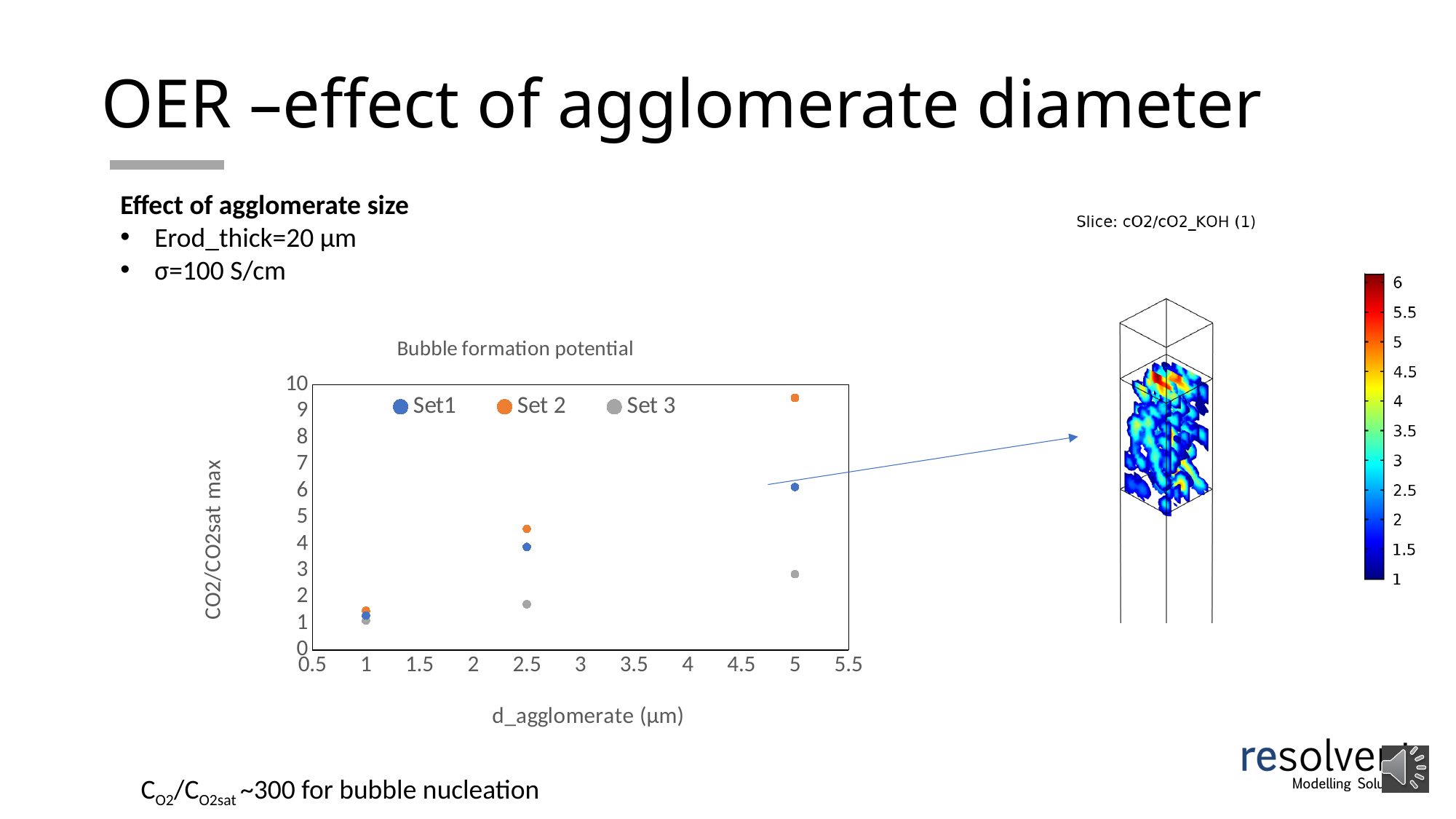
In the 'Bubble formation potential' chart, which is larger at d_agglomerate = 2.5 µm: Set1 or Set 2? Set 2 In the 'Bubble formation potential' chart, is the value for Set 3 at d_agglomerate = 5 µm greater or less than 4? less How many data points are plotted for Set 2 in the 'Bubble formation potential' chart? 3 What is the x-axis label of the 'Bubble formation potential' chart? d_agglomerate (µm) In the 'Bubble formation potential' chart, do the Set 2 values rise or fall as d_agglomerate increases? rise In the 'Bubble formation potential' chart, which series has the highest value at d_agglomerate = 5 µm? Set 2 How many series does the legend of the 'Bubble formation potential' chart list? 3 What kind of chart is the 'Bubble formation potential' chart? scatter chart In the 'Bubble formation potential' chart, which series has the lowest value at d_agglomerate = 2.5 µm? Set 3 In the 'Bubble formation potential' chart, is the value for Set 2 at d_agglomerate = 5 µm greater or less than 8? greater In the 'Bubble formation potential' chart, is the value for Set1 at d_agglomerate = 2.5 µm greater or less than 3? greater